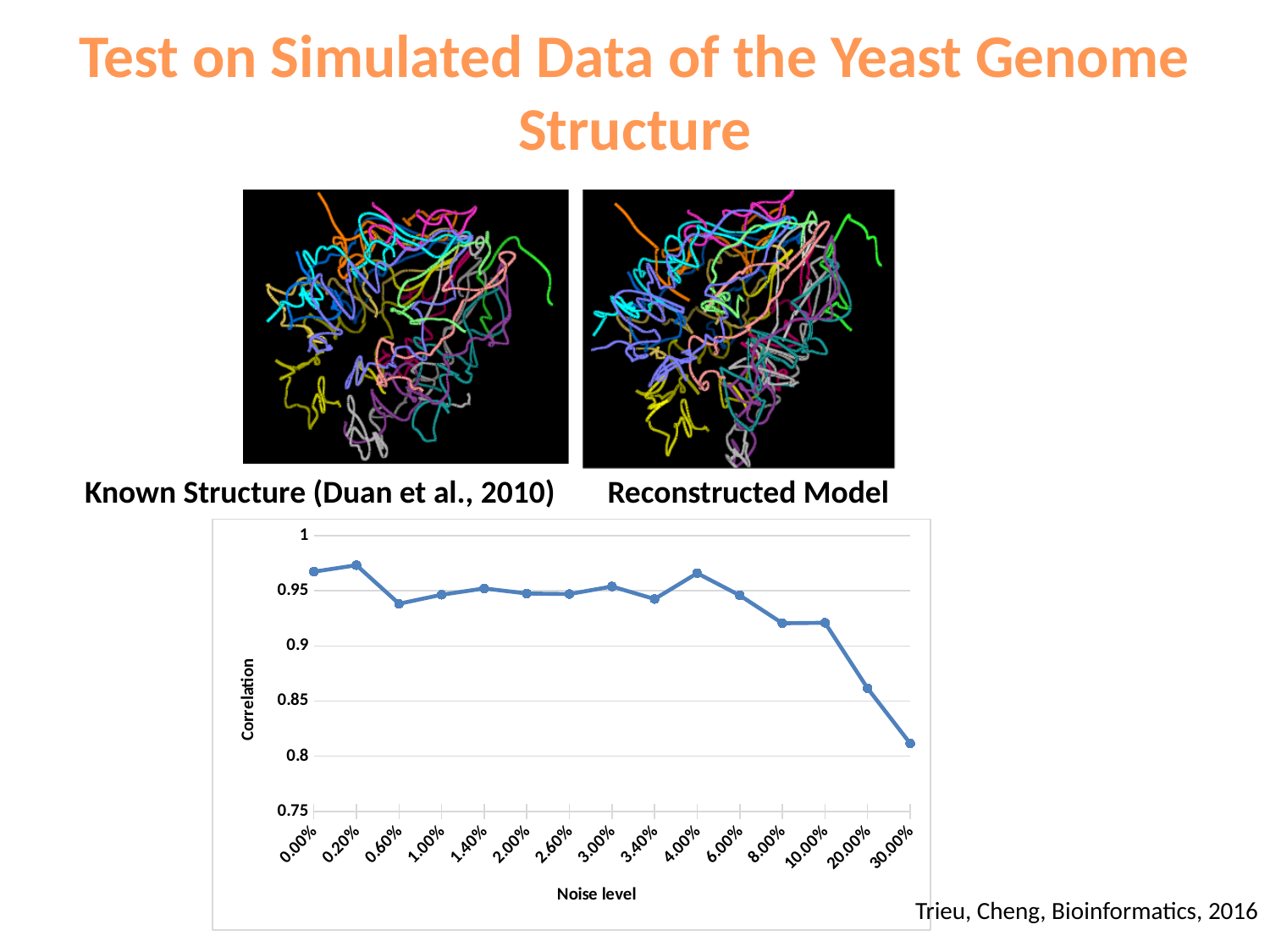
How many noise levels are plotted on the x axis of the chart? 15 What is the label of the x axis of the chart? Noise level Is the correlation at a noise level of 8.00% greater or less than 0.9? greater Overall, does the correlation rise or fall as the noise level increases along the x axis? fall Is the correlation at a noise level of 0.20% greater or less than 0.95? greater What kind of chart is shown on the slide? line chart At which noise level is the correlation highest? 0.20% At which noise level is the correlation lowest? 30.00% Which has the higher correlation: a noise level of 10.00% or 20.00%? 10.00% What is the label of the y axis of the chart? Correlation Is the correlation at a noise level of 30.00% greater or less than 0.85? less